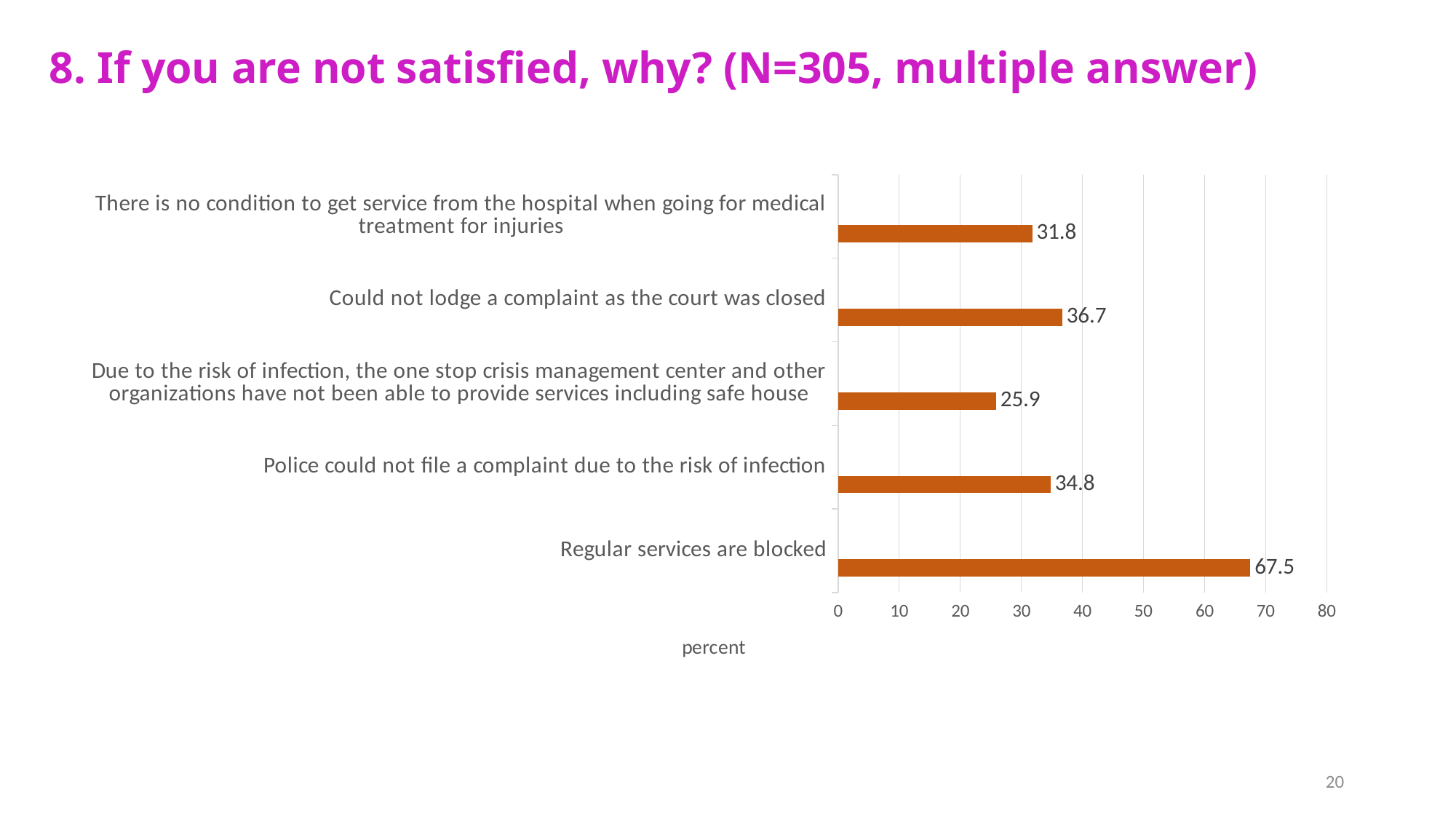
What is the value for "Regular services are blocked"? 67.5 What is the value for "Could not lodge a complaint as the court was closed"? 36.7 Which category has the lowest value? Due to the risk of infection, the one stop crisis management center and other organizations have not been able to provide services including safe house What kind of chart is shown on the slide? bar chart What is the value for "There is no condition to get service from the hospital when going for medical treatment for injuries"? 31.8 Which category has the highest value? Regular services are blocked Is the value for "Regular services are blocked" greater or less than 60? greater Which is larger: the value for "Could not lodge a complaint as the court was closed" or the value for "Police could not file a complaint due to the risk of infection"? Could not lodge a complaint as the court was closed What is the value for "Police could not file a complaint due to the risk of infection"? 34.8 What is the label on the horizontal axis of the chart? percent How many categories are shown in the chart? 5 What is the difference between the values for "Regular services are blocked" and "Could not lodge a complaint as the court was closed"? 30.8